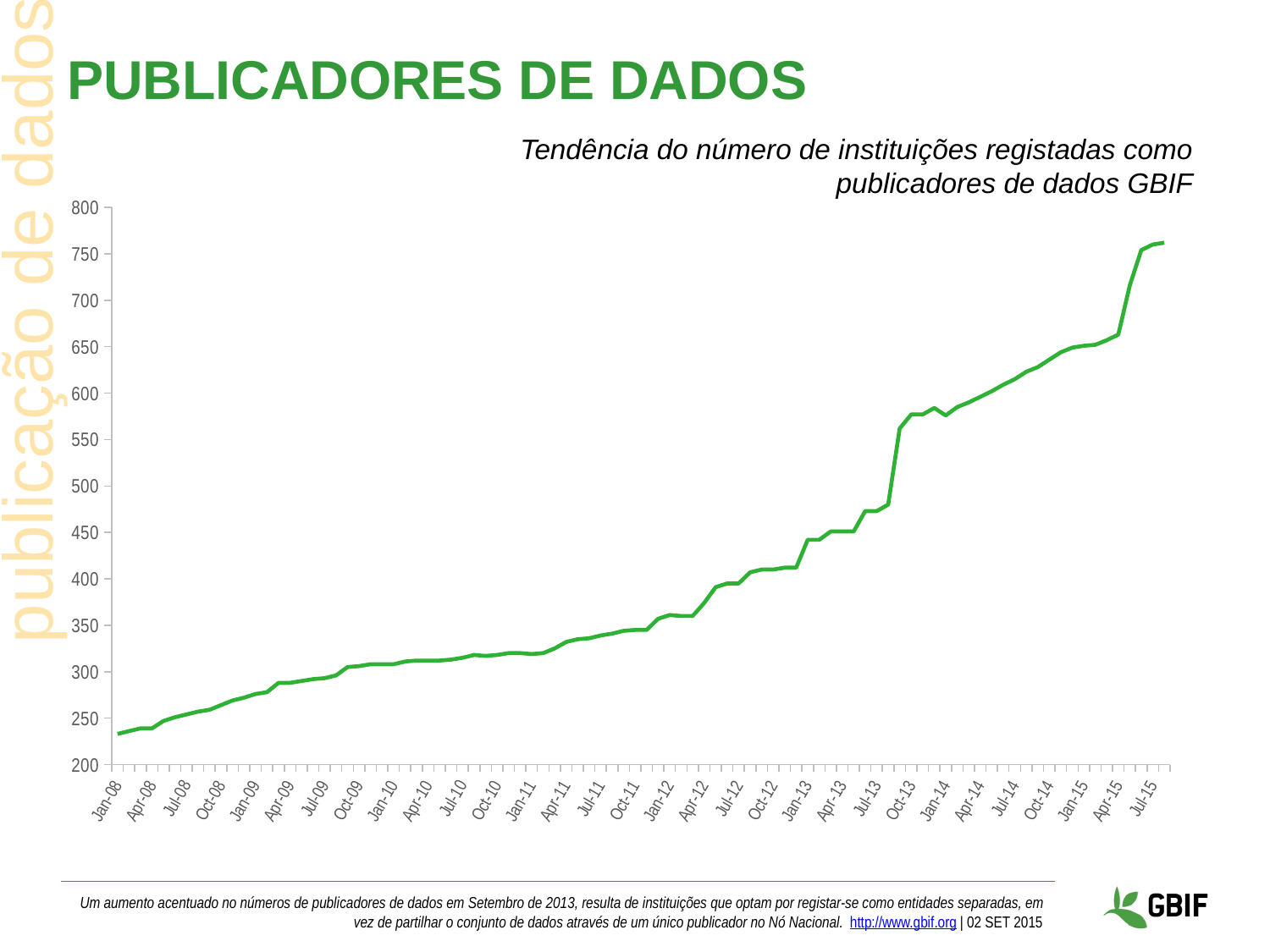
Is the value for Jan-11 greater or less than 350? less Is the value for Jul-14 greater or less than 600? greater Is the value for Jan-12 greater or less than 350? greater What is the highest value shown on the y axis? 800 Do the values rise or fall from Jan-08 to Jul-15? rise Which is larger, the value for Jan-12 or the value for Jan-10? Jan-12 What kind of chart is shown on the slide? line chart At which x-axis label is the value lowest? Jan-08